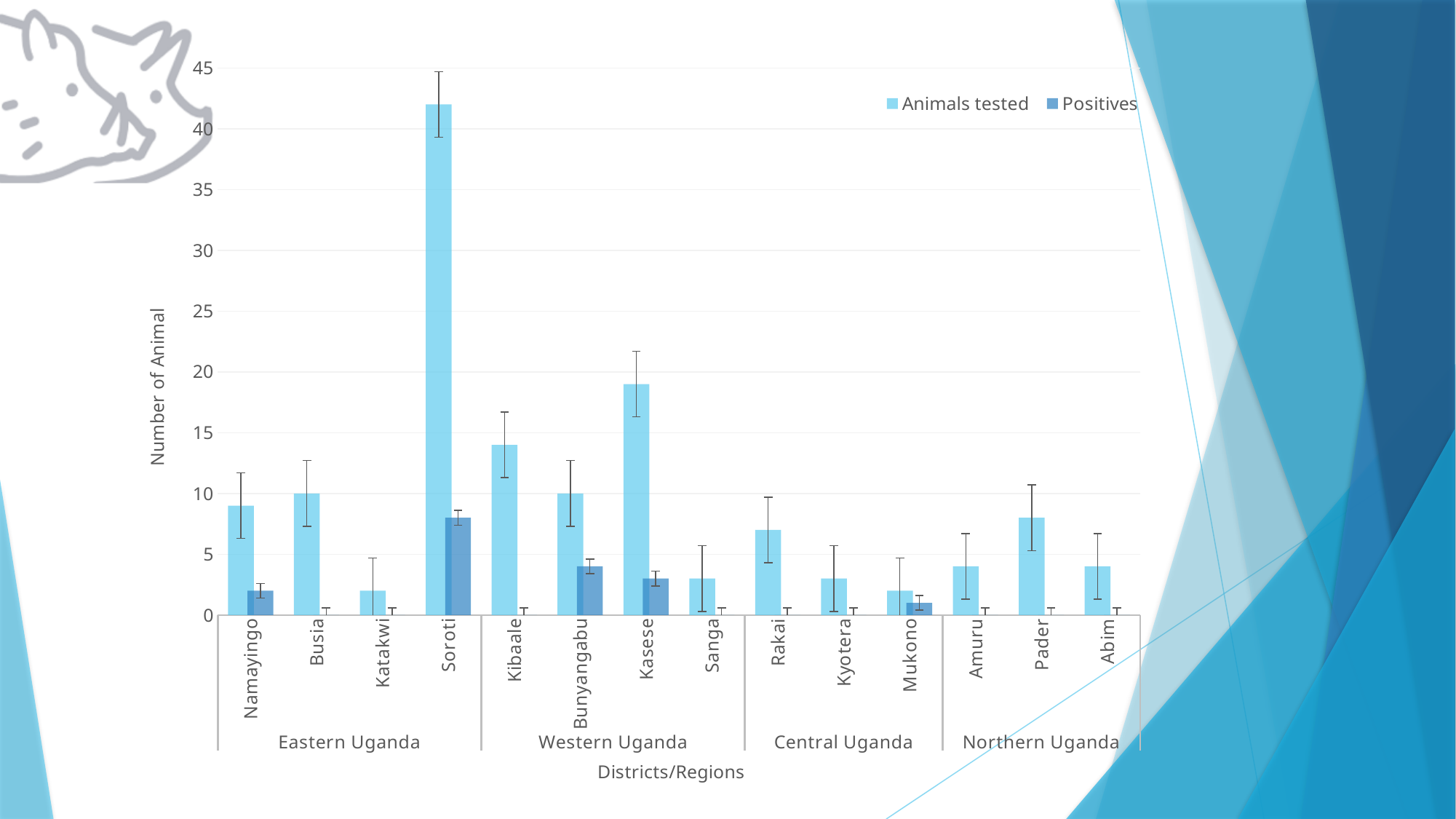
Is the number of animals tested in Soroti greater or less than 40? greater What kind of chart is shown on the slide? bar chart Which district has the highest number of animals tested? Soroti Is the number of animals tested in Rakai greater or less than 10? less Is the number of animals tested in Kasese greater or less than 15? greater How many regions are the districts grouped into on the x axis? 4 How many series does the legend list? 2 Which district has more animals tested, Kibaale or Pader? Kibaale How many districts are shown along the x axis? 14 What is the label of the y axis? Number of Animal Which district has the highest number of positives? Soroti What are the two series named in the legend? Animals tested and Positives